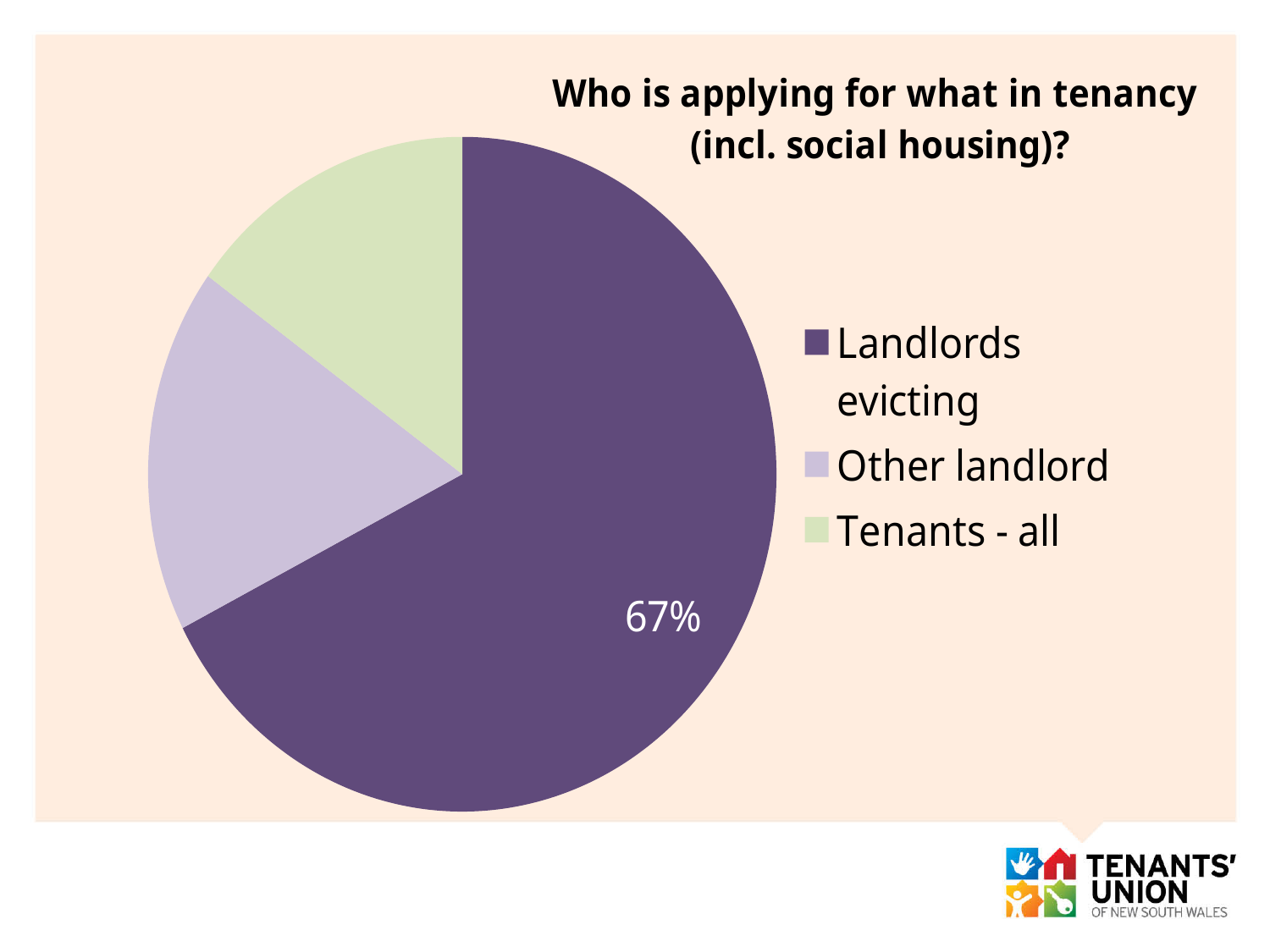
Which category is shown in light green in the pie chart? Tenants - all How many entries does the legend list? 3 What value is printed on the Landlords evicting slice? 67% Which is larger, the Tenants - all slice or the Landlords evicting slice? Landlords evicting How many categories are shown in the pie chart? 3 Which category has the largest slice of the pie? Landlords evicting What is the title of the chart? Who is applying for what in tenancy (incl. social housing)? What kind of chart is shown on the slide? Pie chart What share of the pie does the Landlords evicting slice represent? 67% Which is larger, the Landlords evicting slice or the Other landlord slice? Landlords evicting